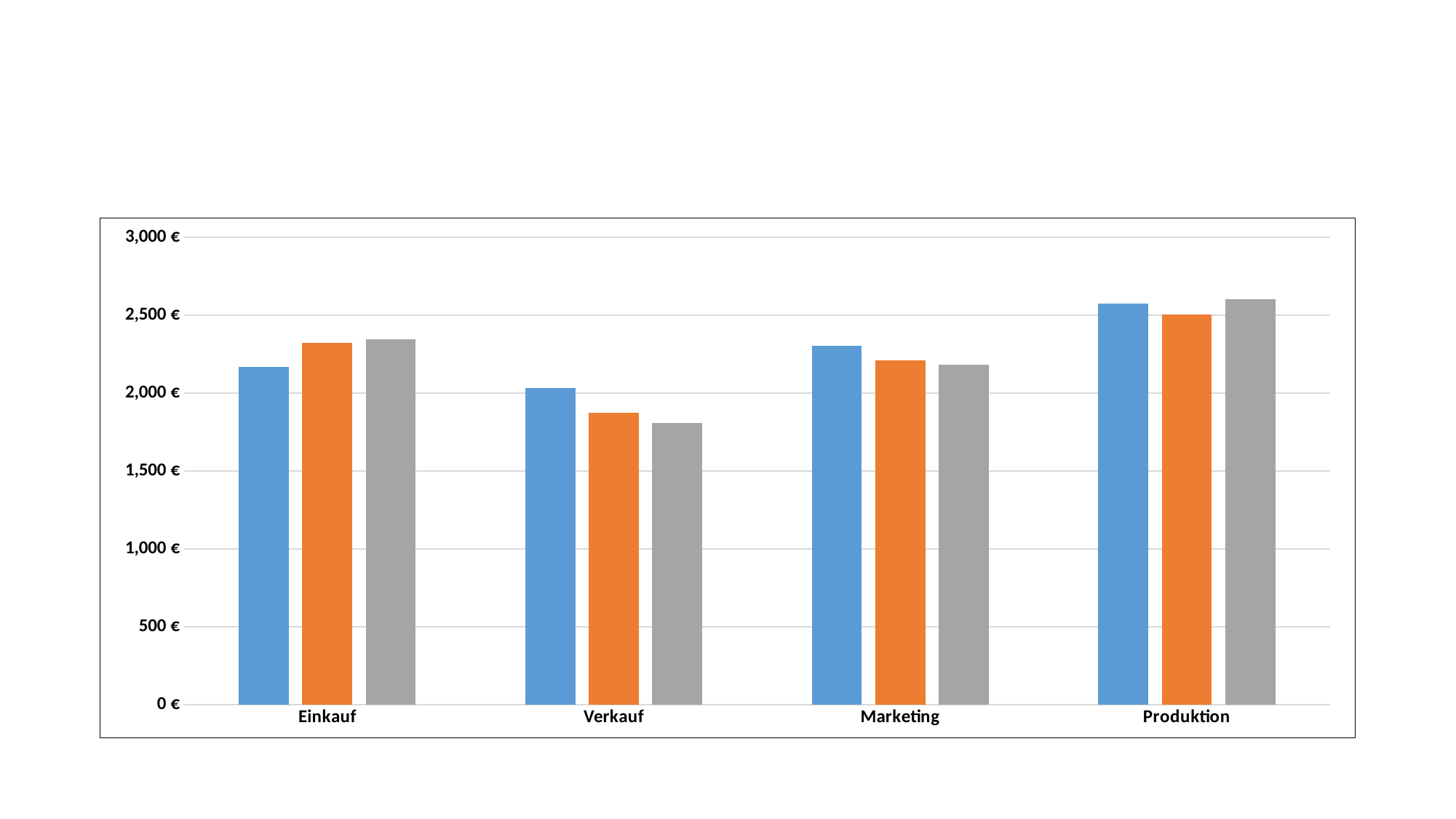
Which category has the shortest gray bar? Verkauf Within the Verkauf category, which is larger, the blue bar or the gray bar? the blue bar How many bars are shown for each category? 3 Is the gray bar for Verkauf greater or less than 2,000 €? less How many categories are shown on the x axis? 4 What kind of chart is shown on the slide? bar chart Which is larger, the blue bar for Einkauf or the blue bar for Marketing? Marketing Is the blue bar for Einkauf greater or less than 2,000 €? greater Is the gray bar for Produktion greater or less than 2,500 €? greater Which category has the shortest orange bar? Verkauf Which category has the tallest blue bar? Produktion